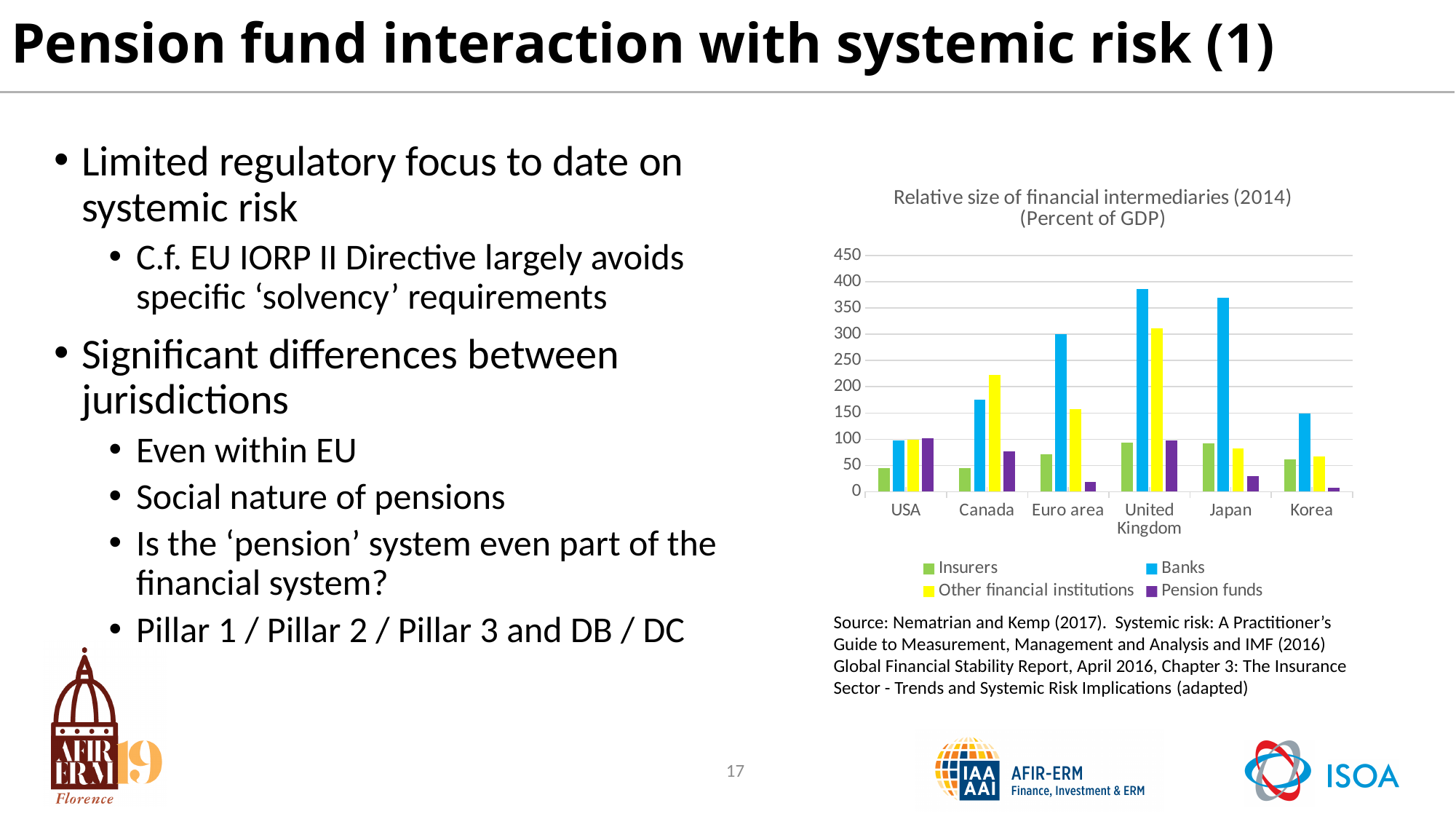
What is the title of the chart? Relative size of financial intermediaries (2014) (Percent of GDP) In Japan, which is larger: Banks or Other financial institutions? Banks In Canada, which is larger: Banks or Other financial institutions? Other financial institutions What kind of chart is shown on the slide? bar chart How many countries or regions are shown on the x axis of the chart? 6 How many series does the chart's legend list? 4 Is the value for Banks in the Euro area greater or less than 250? greater Is the value for Other financial institutions in Canada greater or less than 200? greater Is the value for Pension funds in the Euro area greater or less than 50? less Which country or region has the highest value for Other financial institutions? United Kingdom Which country or region has the lowest value for Pension funds? Korea Which country or region has the highest value for Banks? United Kingdom